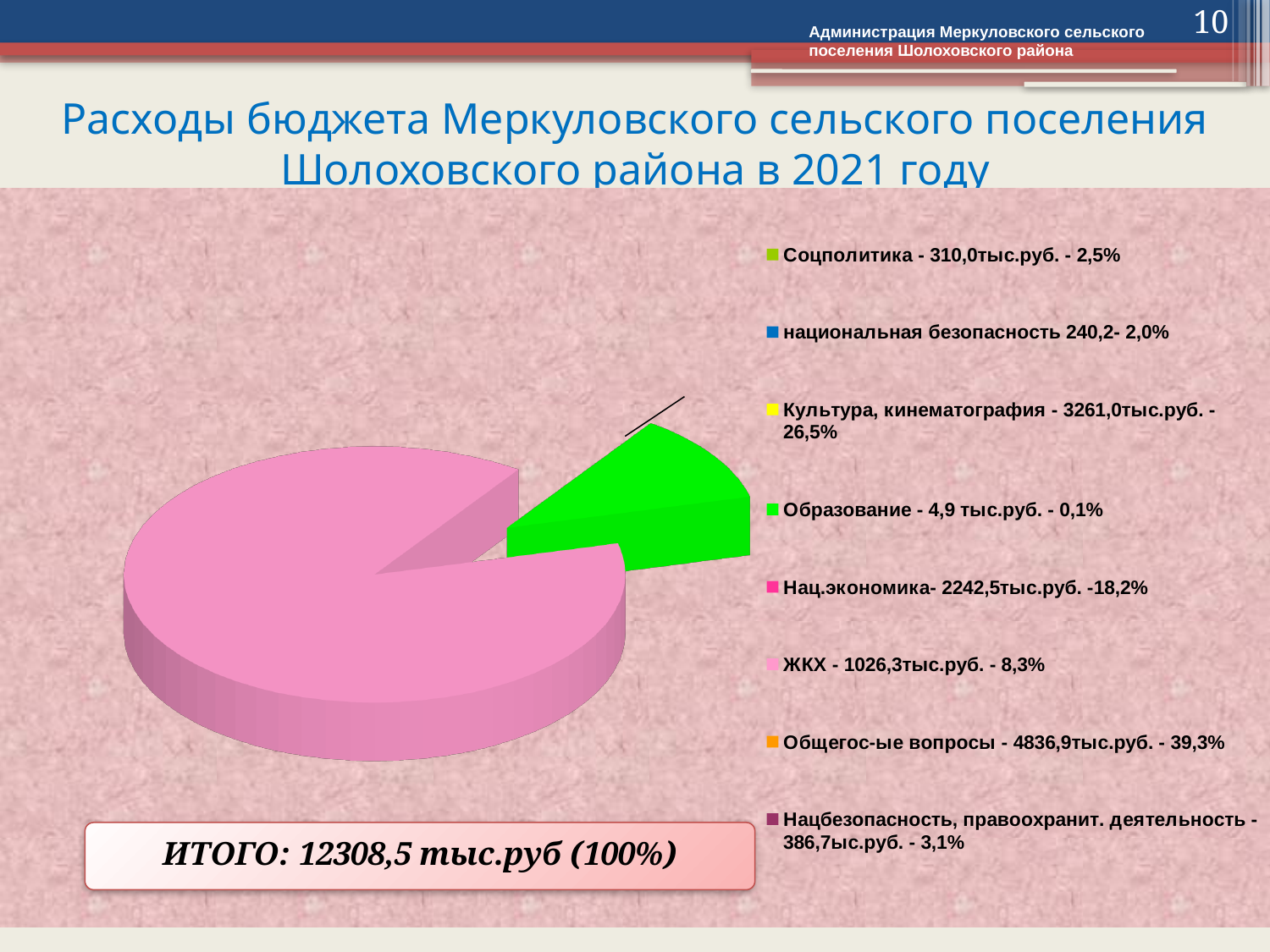
Which category has the largest share of expenses according to the legend? Общегос-ые вопросы What year do the budget expenses in the chart title refer to? 2021 What share of the budget expenses goes to Общегос-ые вопросы according to the legend? 39,3% What is the difference in percentage points between Культура, кинематография and Нац.экономика? 8,3% What is the amount for Культура, кинематография according to the legend? 3261,0тыс.руб. What is the total budget expense shown on the slide (ИТОГО)? 12308,5 тыс.руб Which has a larger share: Соцполитика or национальная безопасность? Соцполитика Which category has the smallest share of expenses according to the legend? Образование What percentage is shown for Нац.экономика in the legend? 18,2% How many categories does the legend of the pie chart list? 8 What is the amount for ЖКХ according to the legend? 1026,3тыс.руб. What kind of chart is shown on the slide? pie chart